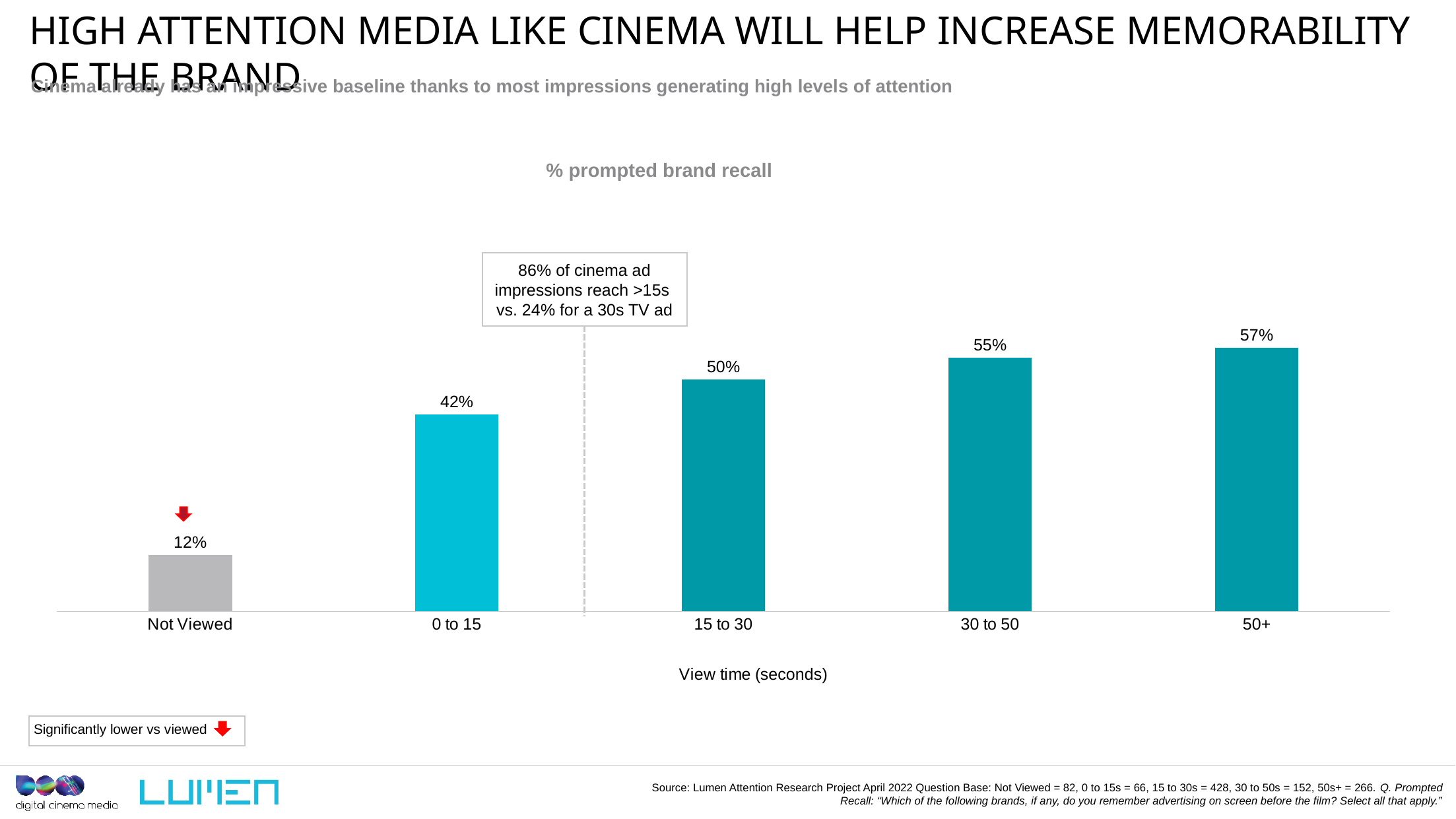
Which has a higher % prompted brand recall: 15 to 30 seconds or 30 to 50 seconds? 30 to 50 What is the % prompted brand recall for a view time of 0 to 15 seconds? 42% How many categories are shown on the x axis of the chart? 5 What is the % prompted brand recall for a view time of 50+ seconds? 57% Do the % prompted brand recall values rise or fall as view time increases along the x axis? Rise Which view time category has the highest % prompted brand recall? 50+ What is the difference in % prompted brand recall between the 0 to 15 category and the Not Viewed category? 30% What is the % prompted brand recall for the 'Not Viewed' category? 12% What is the % prompted brand recall for a view time of 15 to 30 seconds? 50% What kind of chart is shown on the slide? Bar chart What is the difference in % prompted brand recall between the 50+ and 30 to 50 view time categories? 2% Which category has the lowest % prompted brand recall? Not Viewed